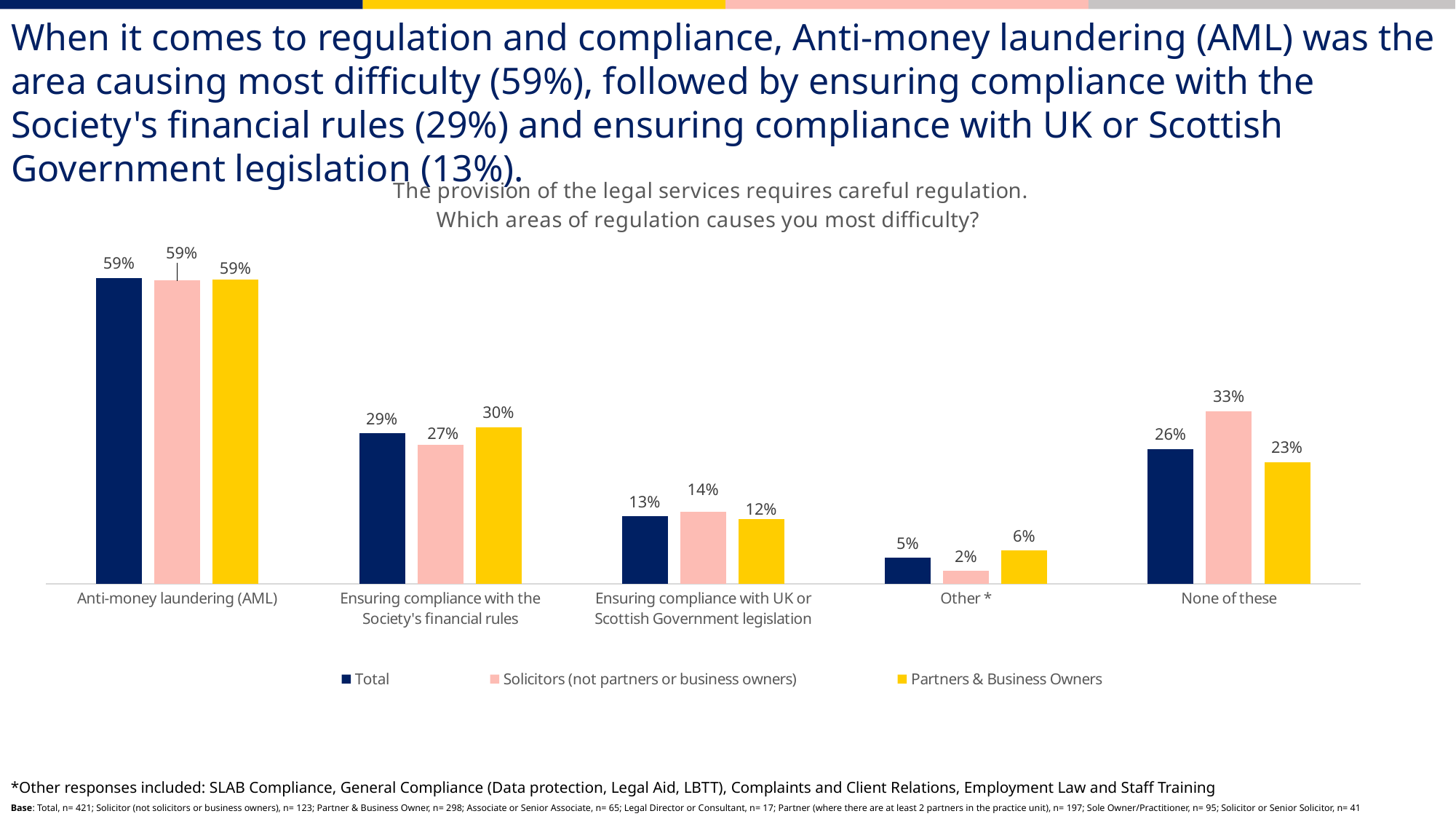
What is the difference between the Total values for Anti-money laundering (AML) and Ensuring compliance with the Society's financial rules? 30% What is the Total value for Anti-money laundering (AML)? 59% Which category has the highest Total value? Anti-money laundering (AML) How many categories are shown on the x axis? 5 What is the value for Partners & Business Owners for Ensuring compliance with the Society's financial rules? 30% What is the value for Solicitors (not partners or business owners) for Other *? 2% For None of these, which series has the larger value: Solicitors (not partners or business owners) or Partners & Business Owners? Solicitors (not partners or business owners) How many series does the legend list? 3 Which category has the lowest Total value? Other * What kind of chart is shown on the slide? Bar chart What is the value for Solicitors (not partners or business owners) for None of these? 33% What colour are the bars for the Partners & Business Owners series? Yellow